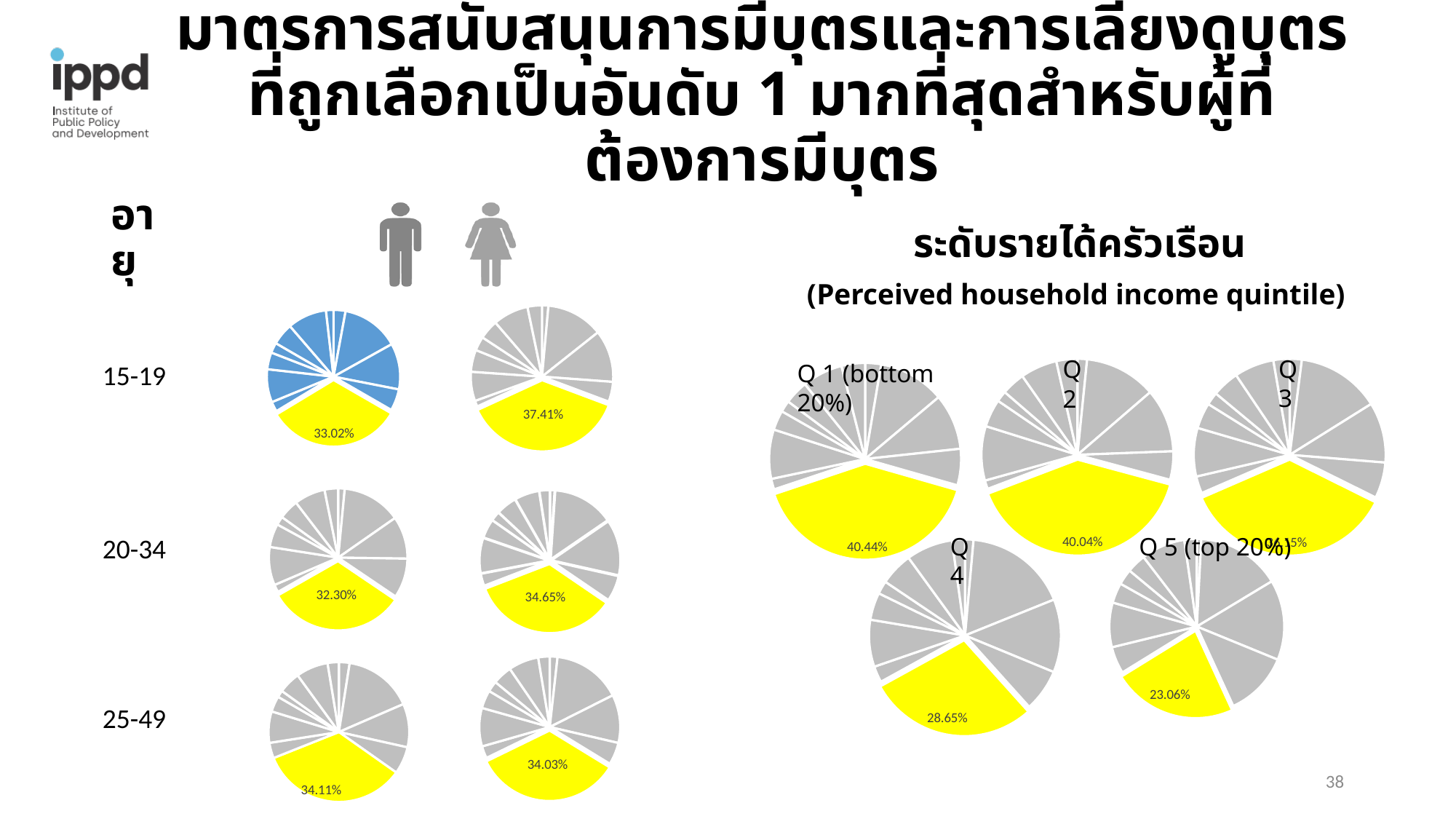
In the pie chart for females aged 25-49, what share is shown for the highlighted (yellow) slice? 34.03% In the household income quintile charts, what share is shown for the highlighted slice in Q 4? 28.65% What kind of chart is used to show the data on this slide? pie chart In the pie chart for males aged 15-19, what share is shown for the highlighted (yellow) slice? 33.02% How many pie charts are shown under the household income quintile heading? 5 In the pie chart for females aged 15-19, what share is shown for the highlighted (yellow) slice? 37.41% Among the household income quintile charts, which quintile has the smallest highlighted share? Q 5 (top 20%) Which is larger: the highlighted share for females aged 15-19 or for males aged 15-19? females aged 15-19 In the household income quintile charts, what share is shown for the highlighted slice in Q 1 (bottom 20%)? 40.44% In the household income quintile charts, what share is shown for the highlighted slice in Q 5 (top 20%)? 23.06% In the pie chart for males aged 20-34, what share is shown for the highlighted (yellow) slice? 32.30% What is the difference between the highlighted share for Q 1 (bottom 20%) and Q 5 (top 20%)? 17.38 percentage points